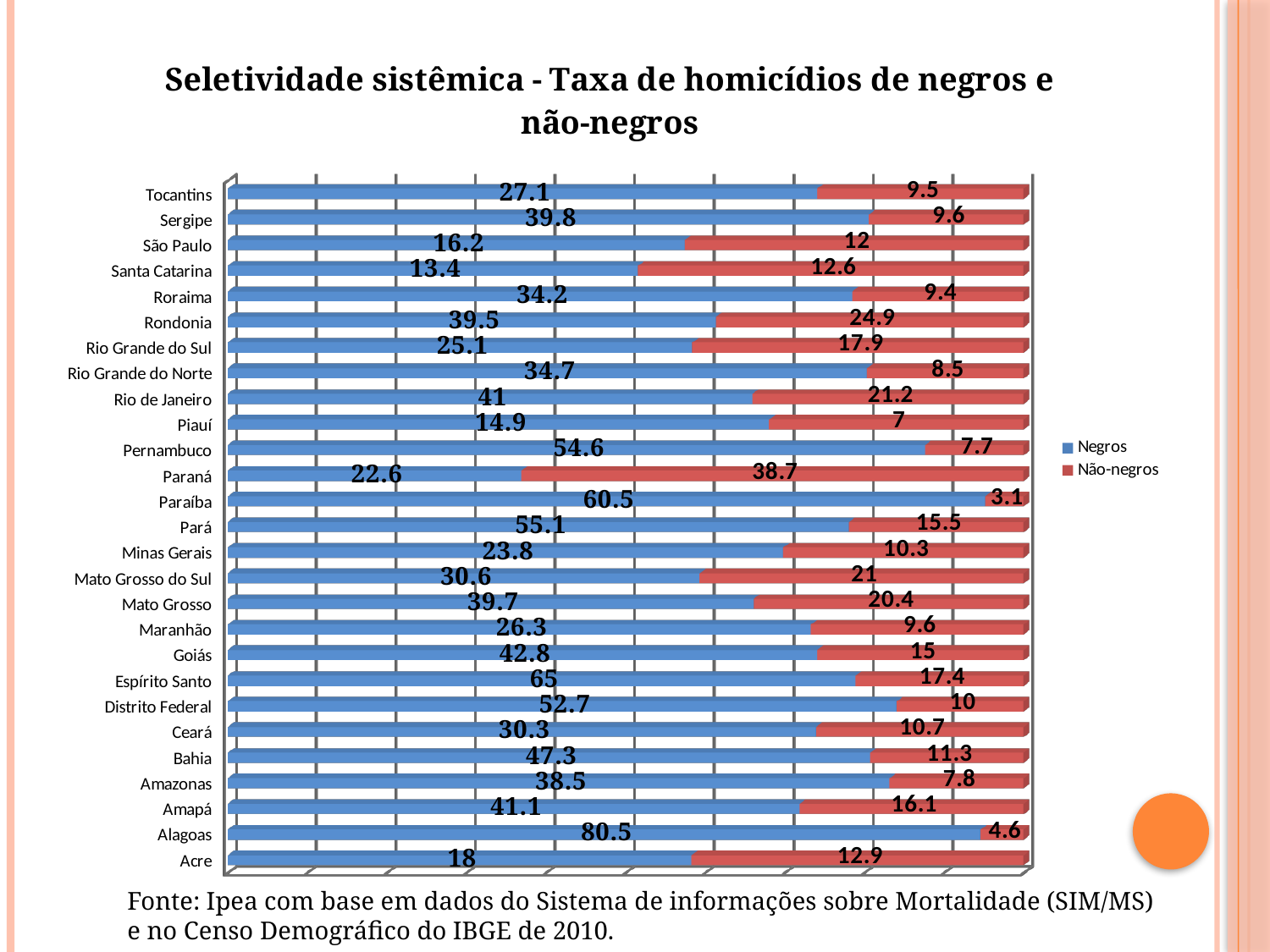
How many series does the legend list? 2 What is the difference between the Negros and Não-negros values for Alagoas? 75.9 Which state has the highest Negros value? Alagoas What is the Não-negros value for Rio de Janeiro? 21.2 Which state has the lowest Não-negros value? Paraíba Which state has the lowest Negros value? Santa Catarina For Paraná, which is larger: the Negros value or the Não-negros value? Não-negros Which state has the highest Não-negros value? Paraná What is the Não-negros value for Paraná? 38.7 What is the Negros value for Alagoas? 80.5 What is the Negros value for Espírito Santo? 65 How many states are shown in the chart? 27